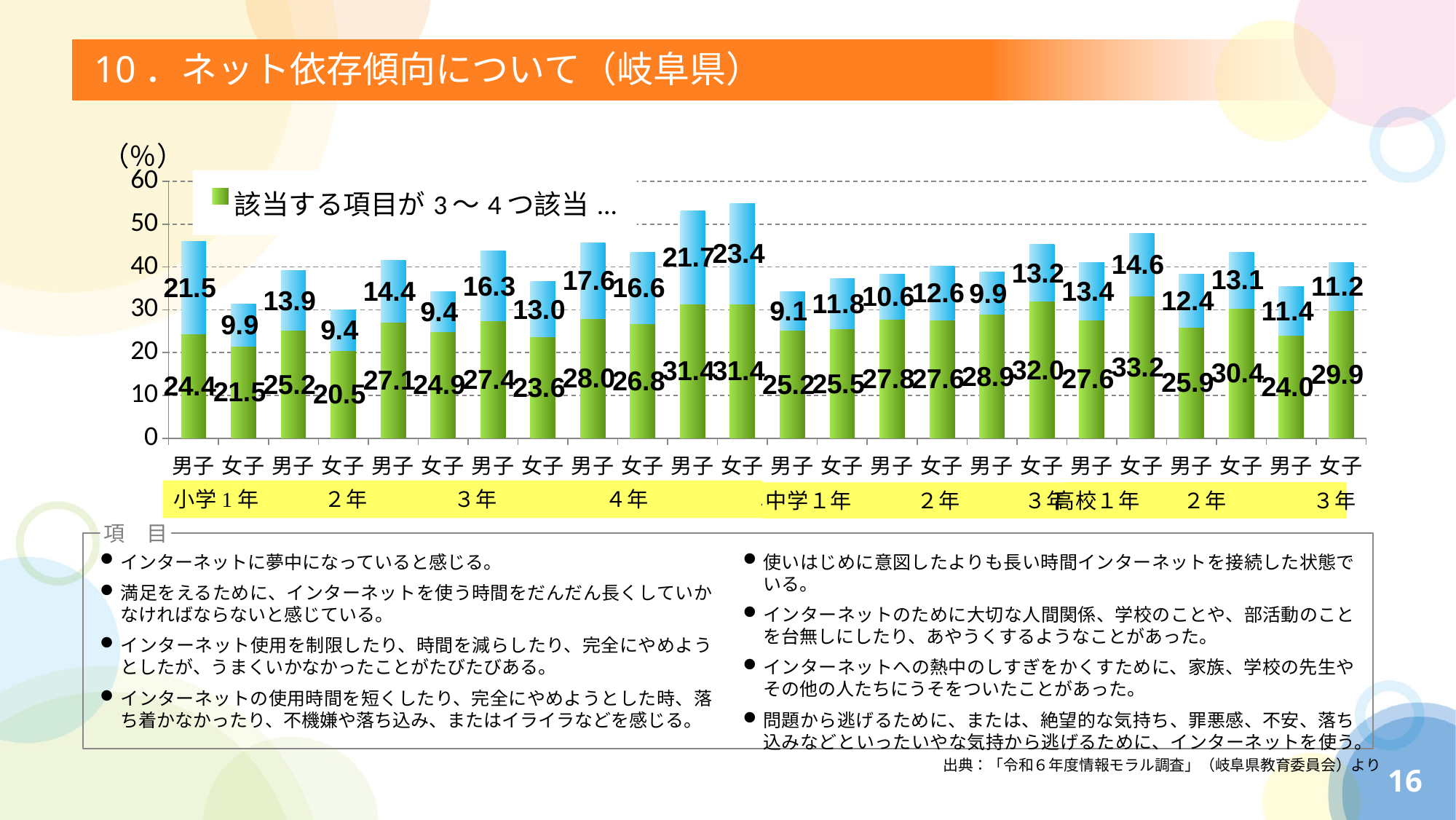
Which bar has the lowest green segment value? 2年 女子 (小学) How many bars are plotted in the chart? 24 Is the total value of the stacked bar for 小学1年 女子 greater or less than 40? less What is the total height of the stacked bar for 小学1年 男子? 45.9 Which bar has the highest green segment value? 高校1年 女子 Which has the larger blue segment value, 小学1年 男子 or 小学1年 女子? 小学1年 男子 What unit is shown at the top of the y axis? (%) Which bar has the lowest blue segment value? 中学1年 男子 What is the difference between the green segment values for 高校1年 女子 and 高校1年 男子? 5.6 What is the value of the blue segment for 中学3年 女子? 13.2 What kind of chart is shown on the slide? stacked bar chart What is the value of the green segment for 小学1年 男子? 24.4